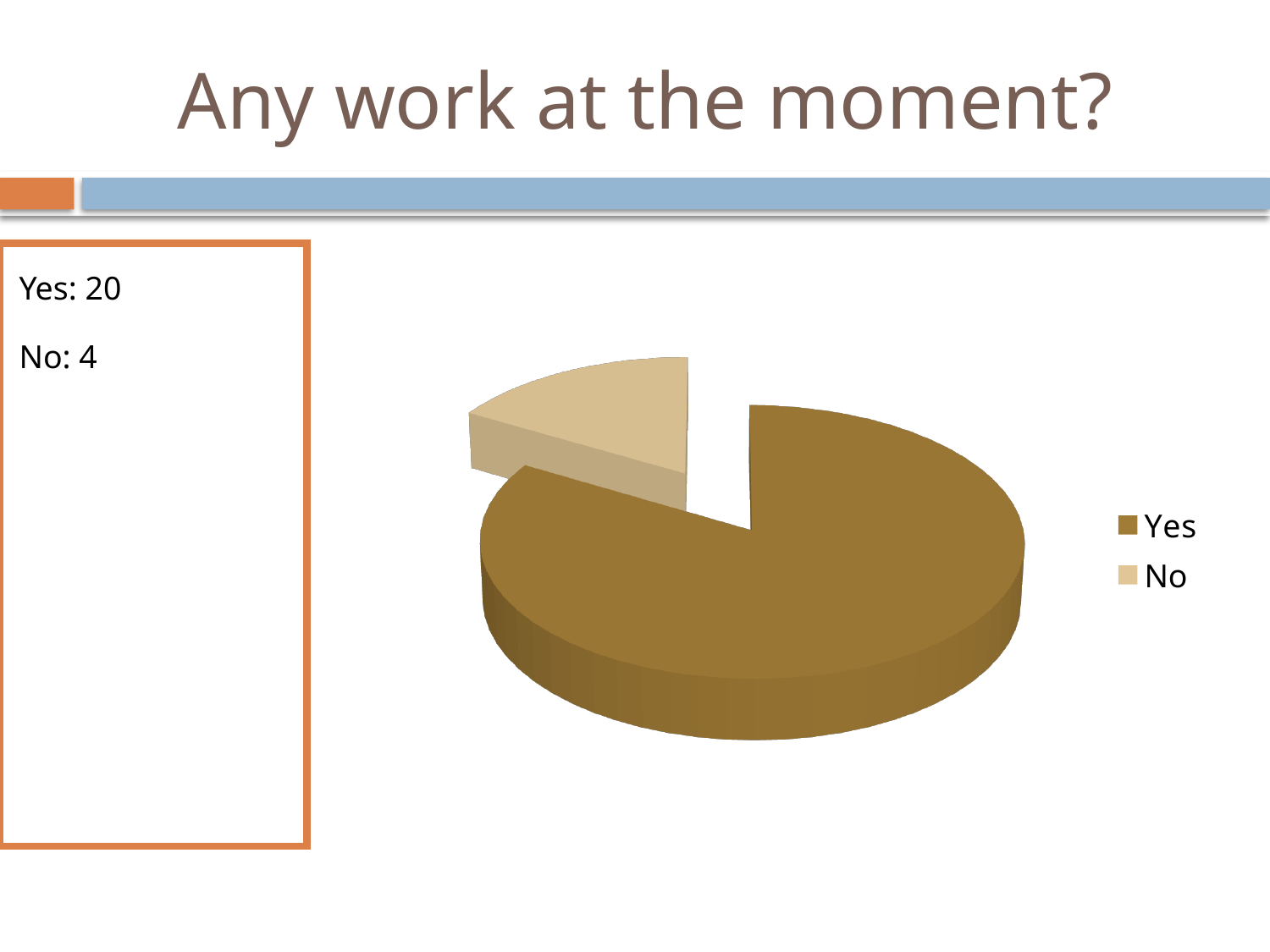
How many slices does the pie chart have? 2 Which category has the largest slice of the pie? Yes Which legend entry is shown in the lighter tan colour? No What is the value for Yes? 20 Which is larger, the value for Yes or the value for No? Yes What is the total of the values for Yes and No? 24 What is the value for No? 4 What kind of chart is shown on the slide? pie chart What is the title of the slide containing the pie chart? Any work at the moment? What is the difference between the value for Yes and the value for No? 16 Which category has the smallest slice of the pie? No How many entries does the legend list? 2